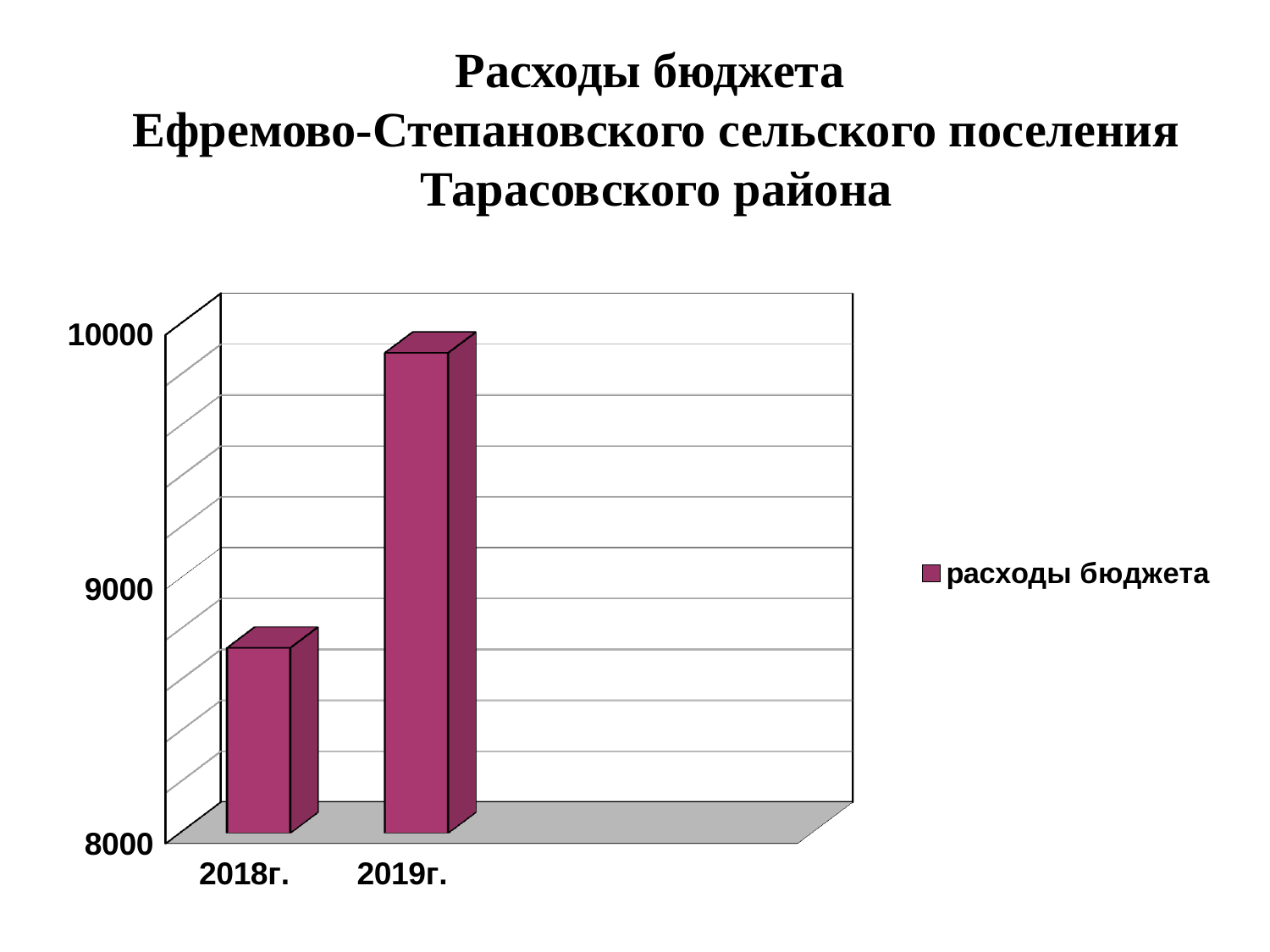
What kind of chart is shown on the slide? bar chart How many categories are shown on the x axis? 2 Which year has the lowest budget expenditure? 2018г. Which is larger, the value for 2018г. or the value for 2019г.? 2019г. How many series does the legend list? 1 What is the legend entry for the series shown? расходы бюджета Which year has the highest budget expenditure? 2019г. Is the value for 2019г. greater or less than 10000? less Is the value for 2019г. greater or less than 9000? greater Is the value for 2018г. greater or less than 9000? less Do the values rise or fall from 2018г. to 2019г.? rise